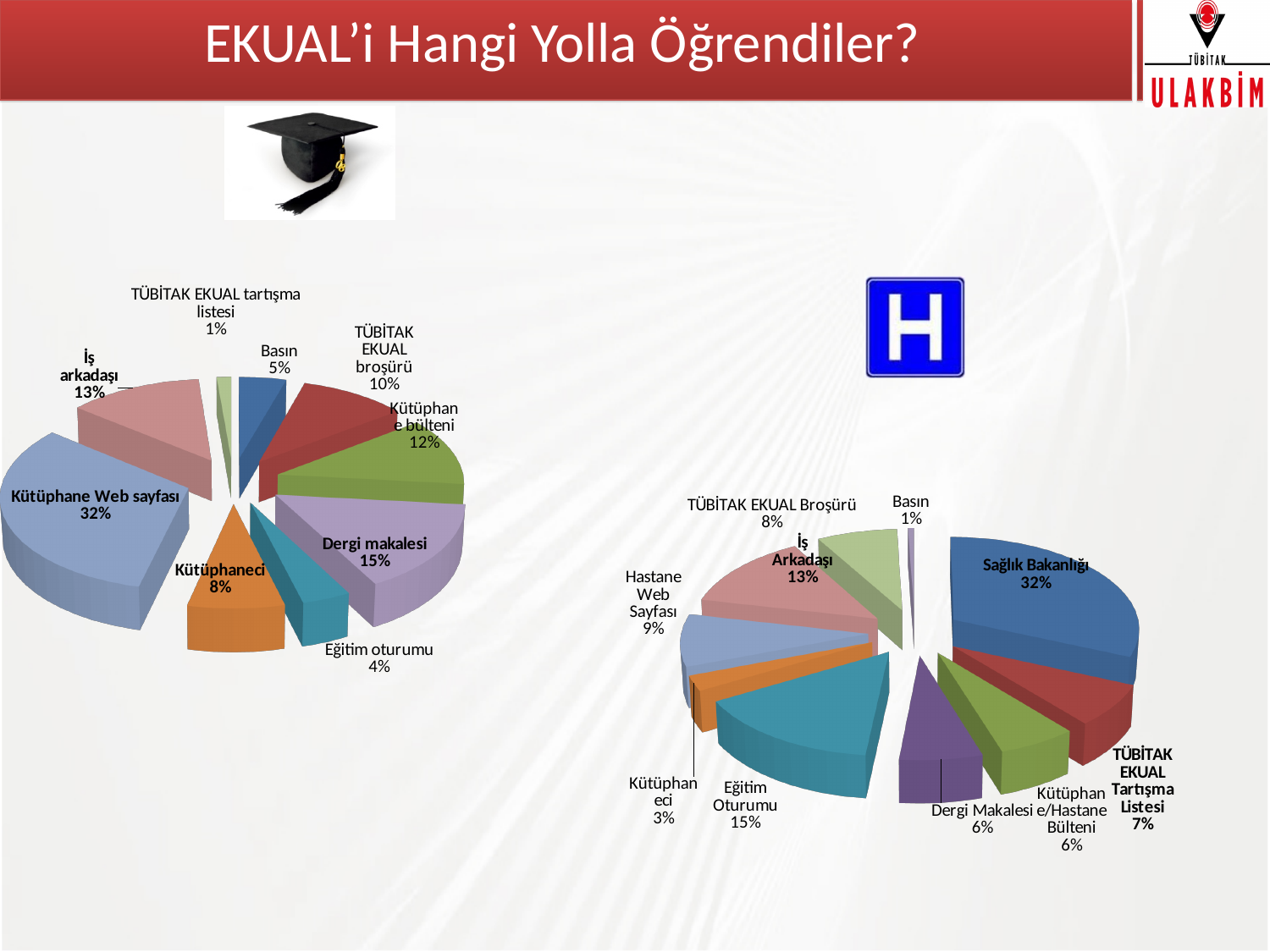
In the right pie chart, which category has the smallest share? Basın In the left pie chart, what share is labelled for Dergi makalesi? 15% In the left pie chart, what is the difference between the shares for Kütüphane bülteni and Kütüphaneci? 4% In the right pie chart, which is larger, the share for Hastane Web Sayfası or the share for TÜBİTAK EKUAL Broşürü? Hastane Web Sayfası In the right pie chart, what share is labelled for Eğitim Oturumu? 15% In the left pie chart, how many categories are shown? 9 In the left pie chart, what share is labelled for Kütüphane Web sayfası? 32% In the left pie chart, which category has the largest share? Kütüphane Web sayfası In the left pie chart, which category has the smallest share? TÜBİTAK EKUAL tartışma listesi What type of chart is used on this slide? Pie chart In the right pie chart, what share is labelled for Sağlık Bakanlığı? 32% In the right pie chart, how many categories are shown? 10